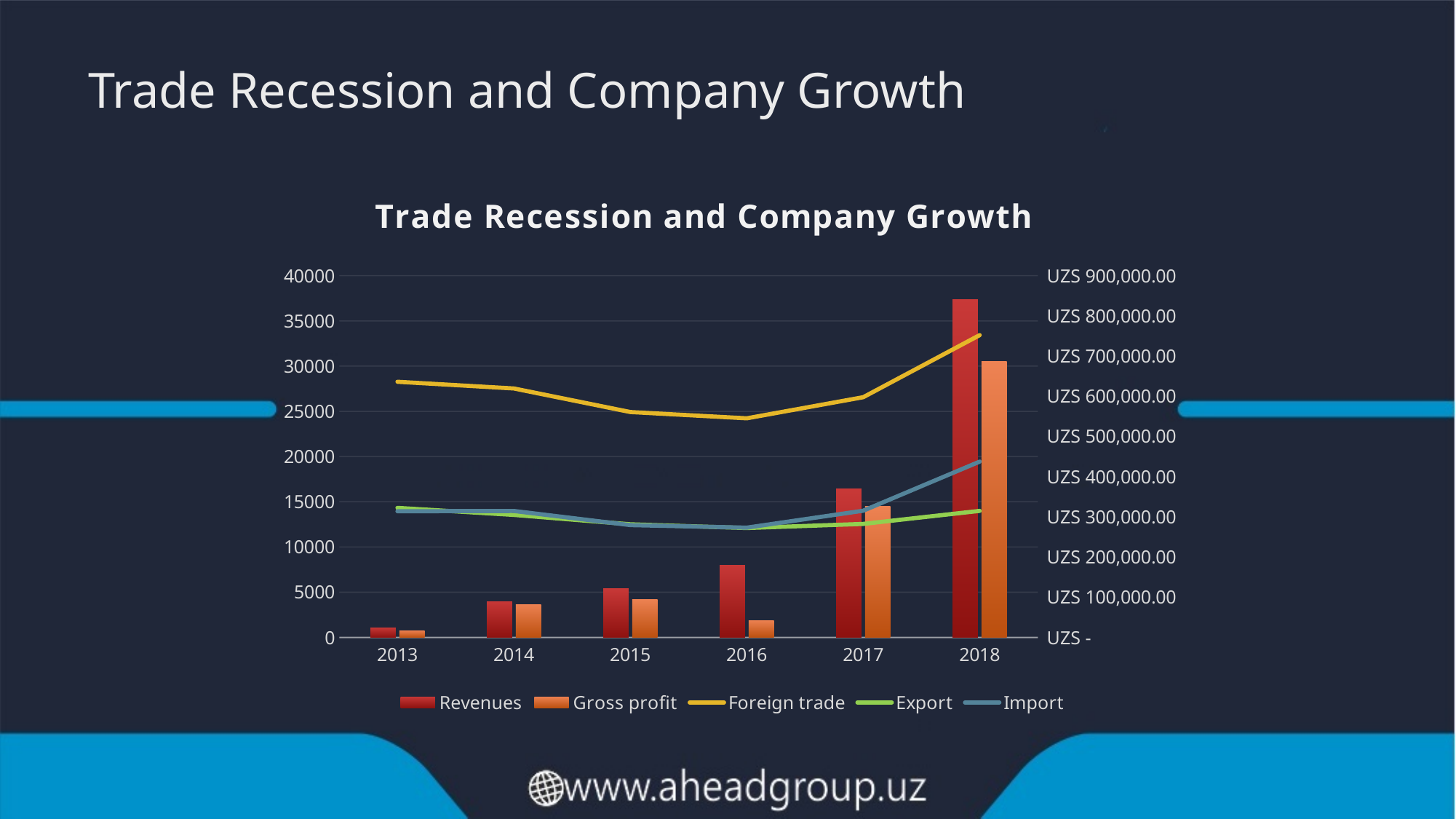
In 2018, which line is higher: Import or Export? Import Reading against the left axis, is the Revenues bar for 2018 greater or less than 35000? greater In which year is the Foreign trade line at its lowest? 2016 How many series does the legend list? 5 Which year has the lowest Revenues bar? 2013 What kind of chart is shown on the slide? A bar chart combined with line series Does the Foreign trade line rise or fall from 2013 to 2016? Fall How many years are shown on the x axis? 6 What is the title of the chart? Trade Recession and Company Growth Do the Revenues bars rise or fall from 2013 to 2018? Rise Which year has the highest Revenues bar? 2018 In 2016, which is larger: Revenues or Gross profit? Revenues